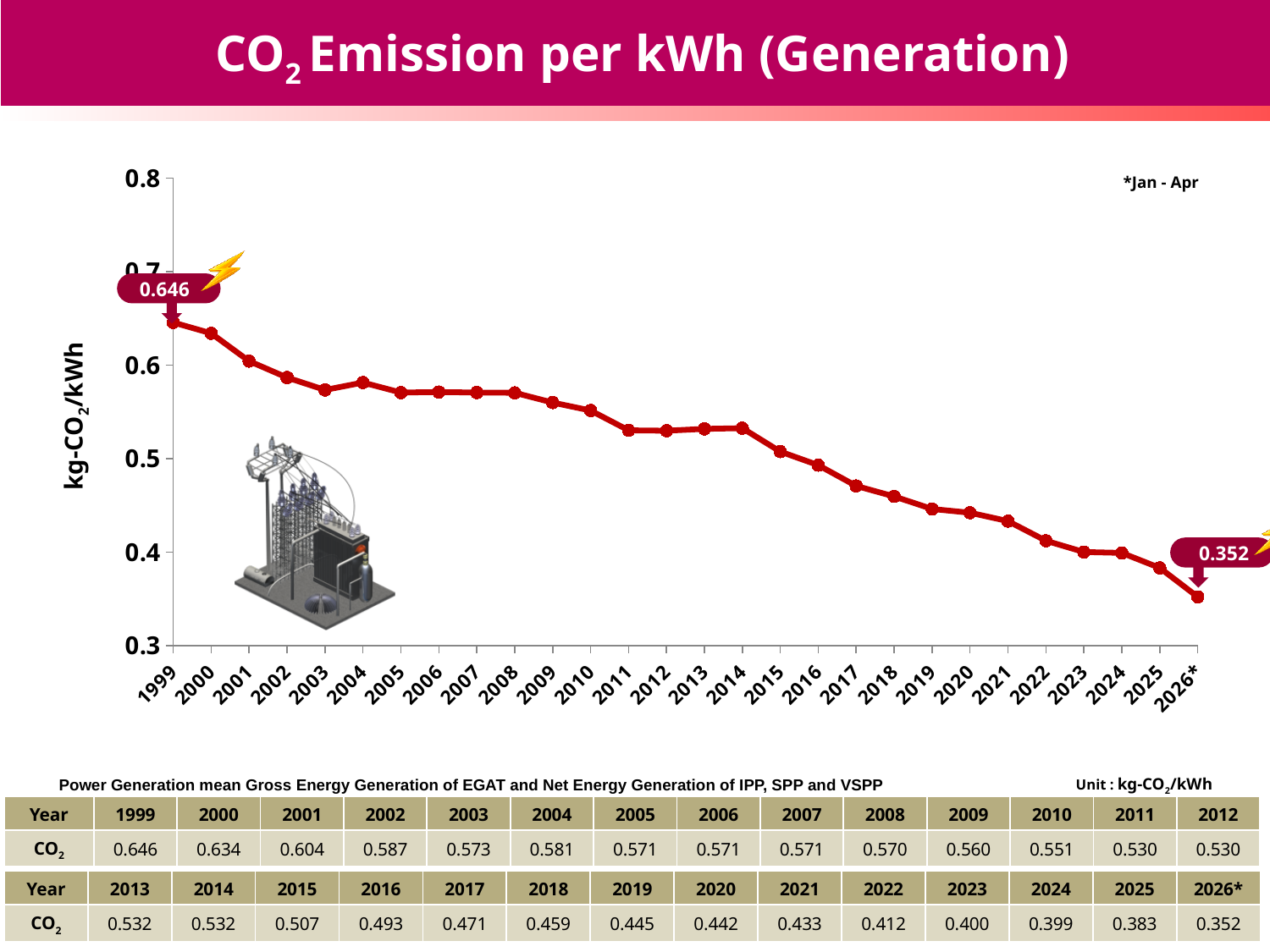
What kind of chart is shown on the slide? line chart What is the CO2 emission per kWh value for 2014? 0.532 What is the CO2 emission per kWh value for 2026*? 0.352 What is the CO2 emission per kWh value for 2020? 0.442 What is the CO2 emission per kWh value for 1999? 0.646 Is the CO2 emission per kWh for 2017 greater or less than 0.5? less How many years are plotted on the x axis of the chart? 28 Does the CO2 emission per kWh generally rise or fall from 1999 to 2026*? fall Which year has the lowest CO2 emission per kWh? 2026* What is the difference between the CO2 emission per kWh in 1999 and in 2026*? 0.294 Which year has a higher CO2 emission per kWh, 2004 or 2010? 2004 Which year has the highest CO2 emission per kWh? 1999